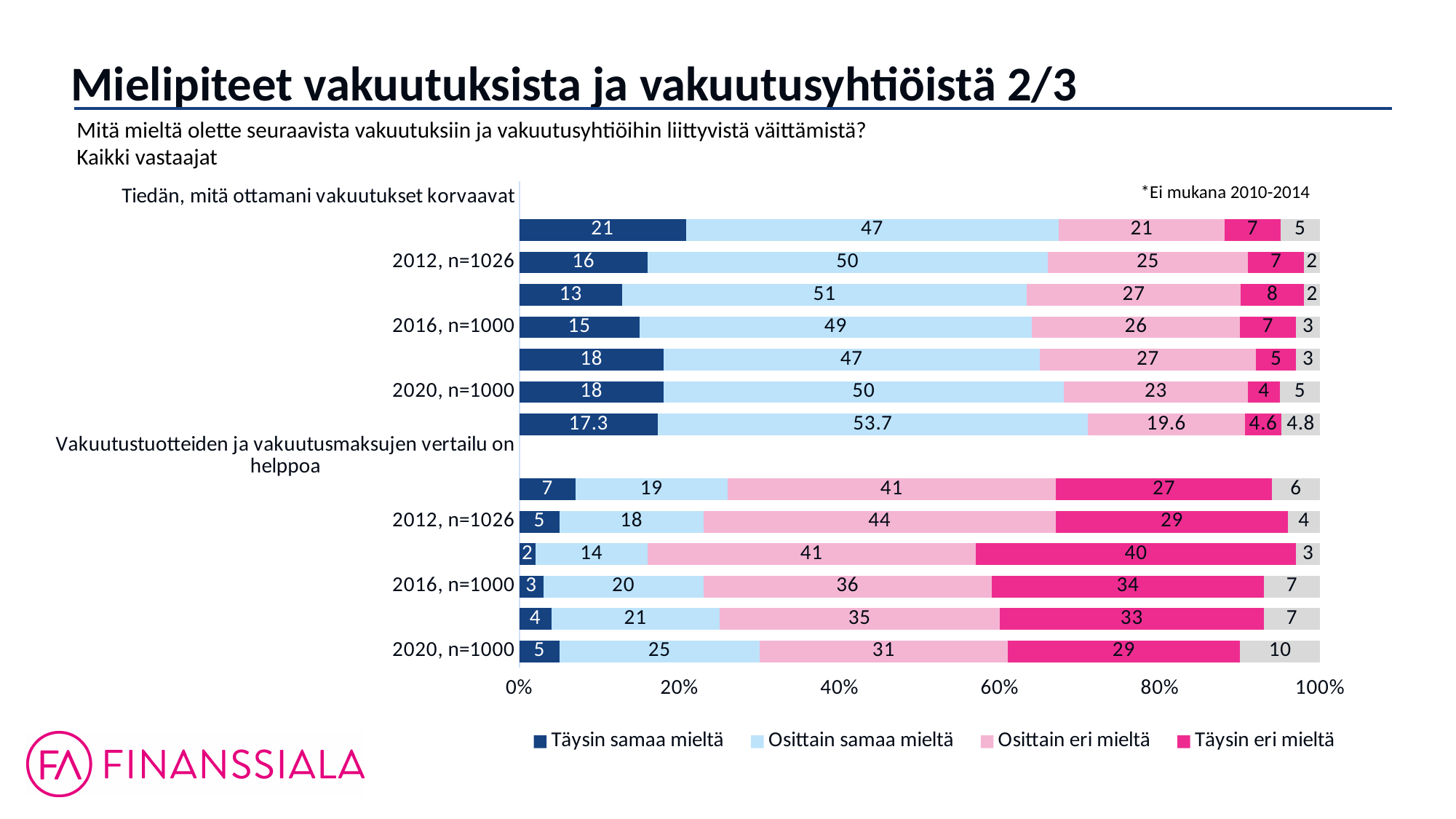
For the statement "Vakuutustuotteiden ja vakuutusmaksujen vertailu on helppoa", what is the value of "Osittain eri mieltä" for 2020, n=1000? 31 What kind of chart is shown on the slide? Stacked bar chart For the statement "Tiedän, mitä ottamani vakuutukset korvaavat", what is the total of the four legend series (Täysin samaa mieltä, Osittain samaa mieltä, Osittain eri mieltä, Täysin eri mieltä) for 2020, n=1000? 95 What colour represents "Täysin samaa mieltä" in the chart legend? Dark blue For the statement "Tiedän, mitä ottamani vakuutukset korvaavat", what is the value of "Osittain eri mieltä" for 2016, n=1000? 26 For the statement "Vakuutustuotteiden ja vakuutusmaksujen vertailu on helppoa", is the "Täysin eri mieltä" value larger for 2016, n=1000 or for 2020, n=1000? 2016, n=1000 For the statement "Vakuutustuotteiden ja vakuutusmaksujen vertailu on helppoa", what is the difference between the "Täysin eri mieltä" values for 2016, n=1000 and 2020, n=1000? 5 For the statement "Vakuutustuotteiden ja vakuutusmaksujen vertailu on helppoa", what is the value of "Täysin eri mieltä" for 2016, n=1000? 34 For the statement "Tiedän, mitä ottamani vakuutukset korvaavat", what is the value of "Täysin samaa mieltä" for 2012, n=1026? 16 For the statement "Tiedän, mitä ottamani vakuutukset korvaavat", is the "Täysin samaa mieltä" value larger for 2012, n=1026 or for 2020, n=1000? 2020, n=1000 How many series does the chart legend list? 4 For the statement "Tiedän, mitä ottamani vakuutukset korvaavat", what is the value of "Osittain samaa mieltä" for 2020, n=1000? 50